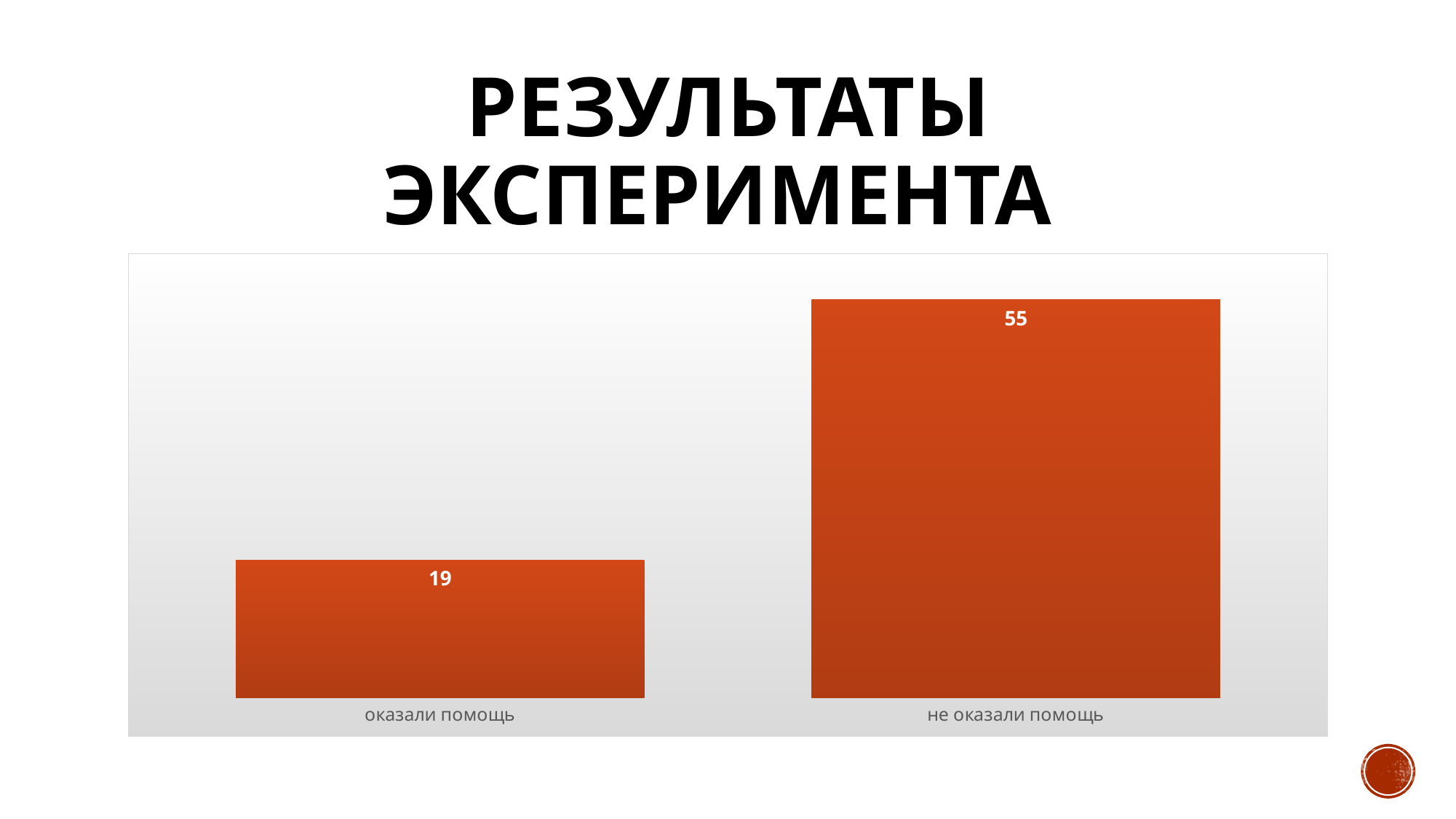
What is the value for "не оказали помощь"? 55 How many categories are shown in the chart? 2 What kind of chart is shown on the slide? bar chart What is the title of the slide? РЕЗУЛЬТАТЫ ЭКСПЕРИМЕНТА What is the value for "оказали помощь"? 19 Which is larger: the value for "оказали помощь" or the value for "не оказали помощь"? не оказали помощь What colour are the bars in the chart? orange-red Do the values rise or fall from left to right along the x axis? rise What is the total of the two values shown in the chart? 74 Which category has the lowest value? оказали помощь Which category has the highest value? не оказали помощь What is the difference between the values for "не оказали помощь" and "оказали помощь"? 36